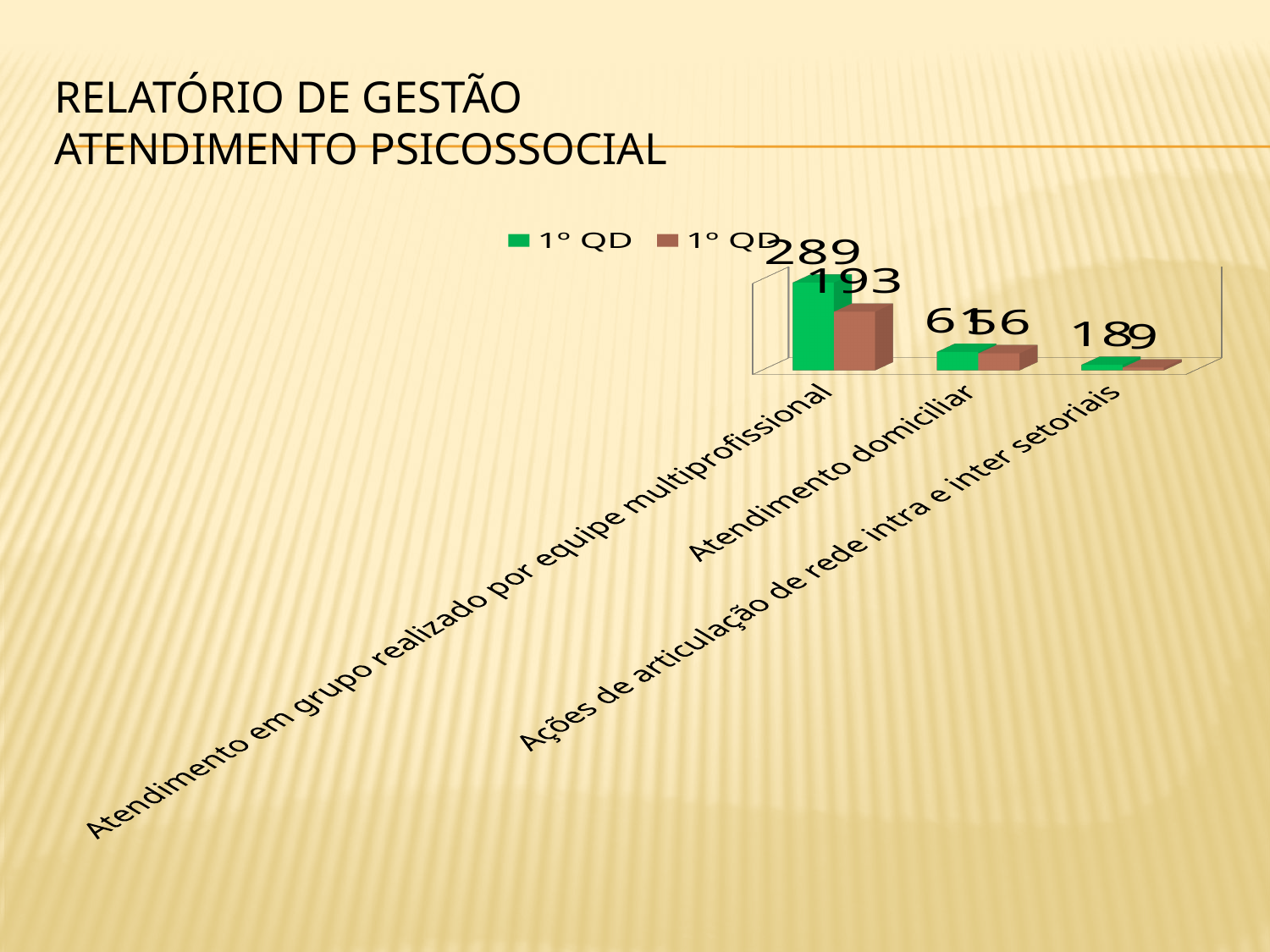
What is the value of the green bar for 'Atendimento em grupo realizado por equipe multiprofissional'? 289 What is the value of the brown bar for 'Atendimento domiciliar'? 56 What label is shown in the legend for the green series? 1º QD For 'Atendimento em grupo realizado por equipe multiprofissional', which bar is larger, the green or the brown? green Which category has the lowest brown bar? Ações de articulação de rede intra e inter setoriais What type of chart is shown on the slide? bar chart Which category has the highest green bar? Atendimento em grupo realizado por equipe multiprofissional What is the value of the green bar for 'Atendimento domiciliar'? 61 How many series does the chart legend list? 2 What is the value of the brown bar for 'Atendimento em grupo realizado por equipe multiprofissional'? 193 What is the difference between the green and brown bars for 'Atendimento em grupo realizado por equipe multiprofissional'? 96 How many categories are shown on the x axis of the chart? 3